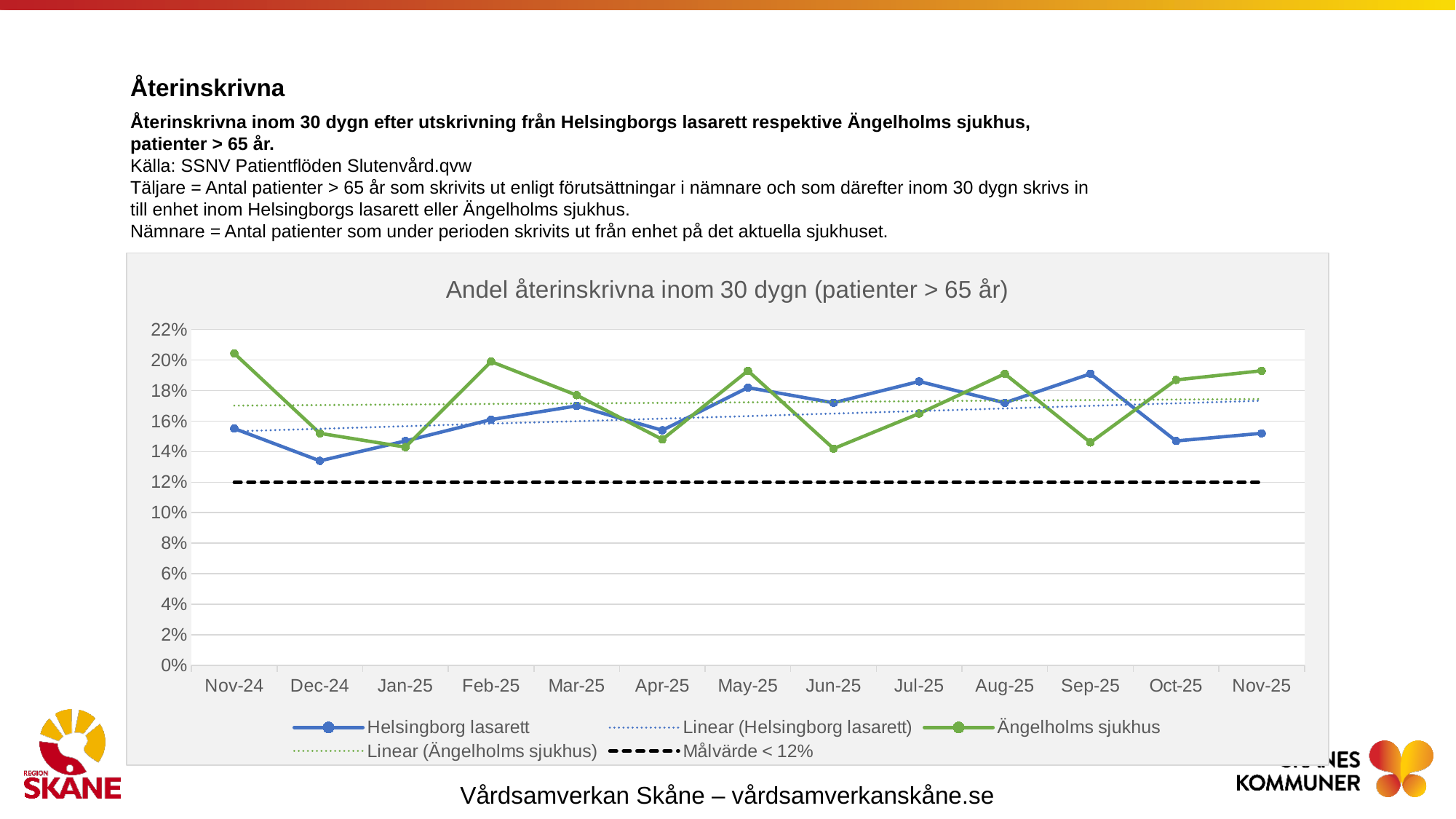
In Sep-25, which has the higher value: Helsingborg lasarett or Ängelholms sjukhus? Helsingborg lasarett What kind of chart is shown on the slide? line chart How many months are shown on the x axis of the chart? 13 Is the value for Helsingborg lasarett in Dec-24 greater or less than 14%? less Is the value for Ängelholms sjukhus in Jun-25 greater or less than 16%? less What target value (Målvärde) is shown by the dashed black line? 12% What is the title of the chart? Andel återinskrivna inom 30 dygn (patienter > 65 år) How many entries does the chart legend list? 5 Does the value for Helsingborg lasarett rise or fall from Nov-24 to Dec-24? fall In Nov-24, which has the higher value: Helsingborg lasarett or Ängelholms sjukhus? Ängelholms sjukhus Is the value for Ängelholms sjukhus in Nov-24 greater or less than 20%? greater In which month is the value for Helsingborg lasarett lowest? Dec-24